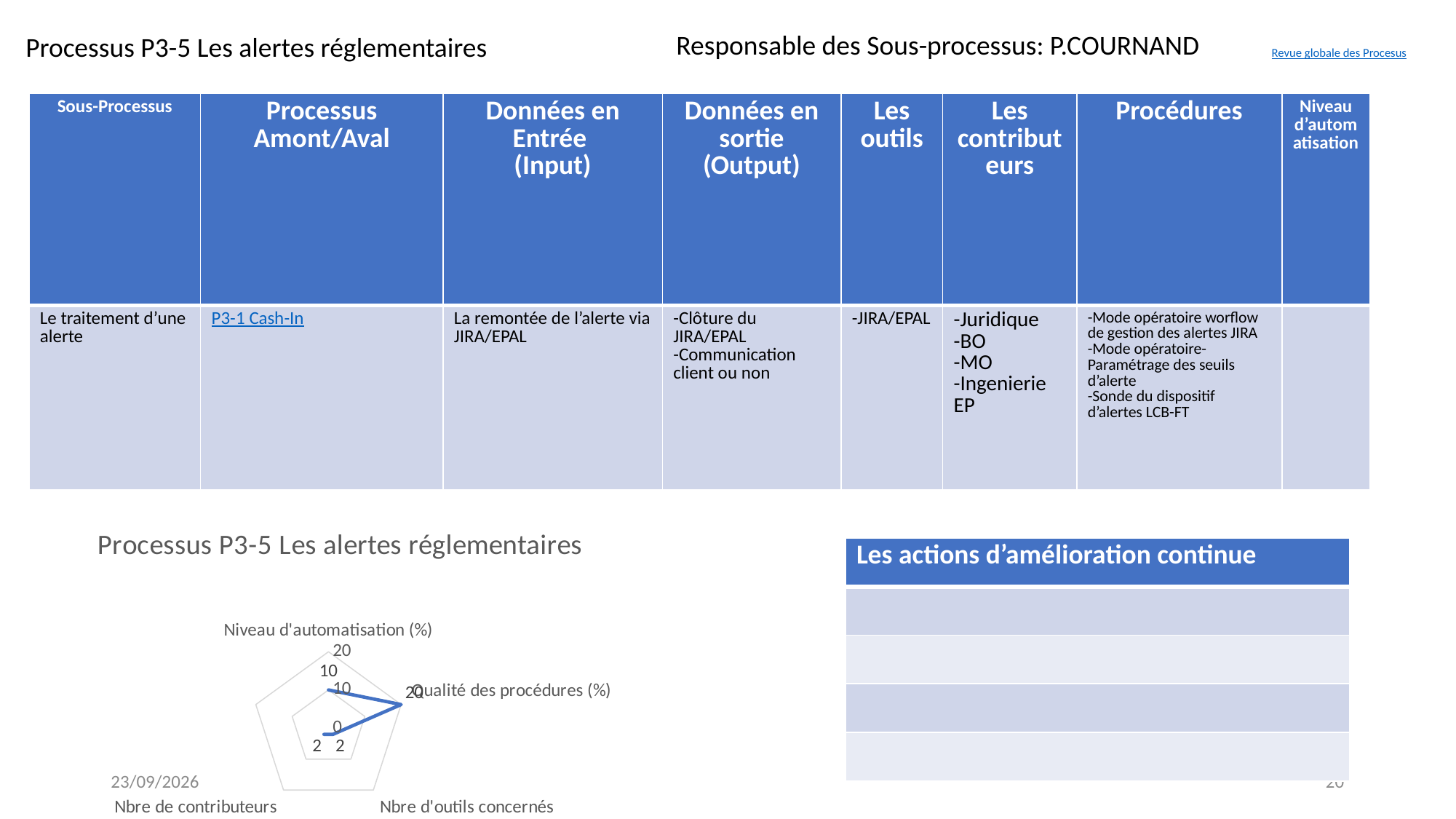
What is the title of the chart at the bottom left of the slide? Processus P3-5 Les alertes réglementaires How many axes does the radar chart have? 5 What colour is the data line in the radar chart? Blue In the radar chart, what is the value for Nbre de contributeurs? 2 In the radar chart, is the value for Niveau d'automatisation (%) greater or less than 20? less What kind of chart is shown at the bottom left of the slide? Radar chart In the radar chart, which is larger: Qualité des procédures (%) or Niveau d'automatisation (%)? Qualité des procédures (%) In the radar chart, which axis has the highest value? Qualité des procédures (%) In the radar chart, what is the value for Qualité des procédures (%)? 20 In the radar chart, what is the value for Niveau d'automatisation (%)? 10 In the radar chart, what is the value for Nbre d'outils concernés? 2 In the radar chart, what is the difference between the value for Qualité des procédures (%) and the value for Niveau d'automatisation (%)? 10